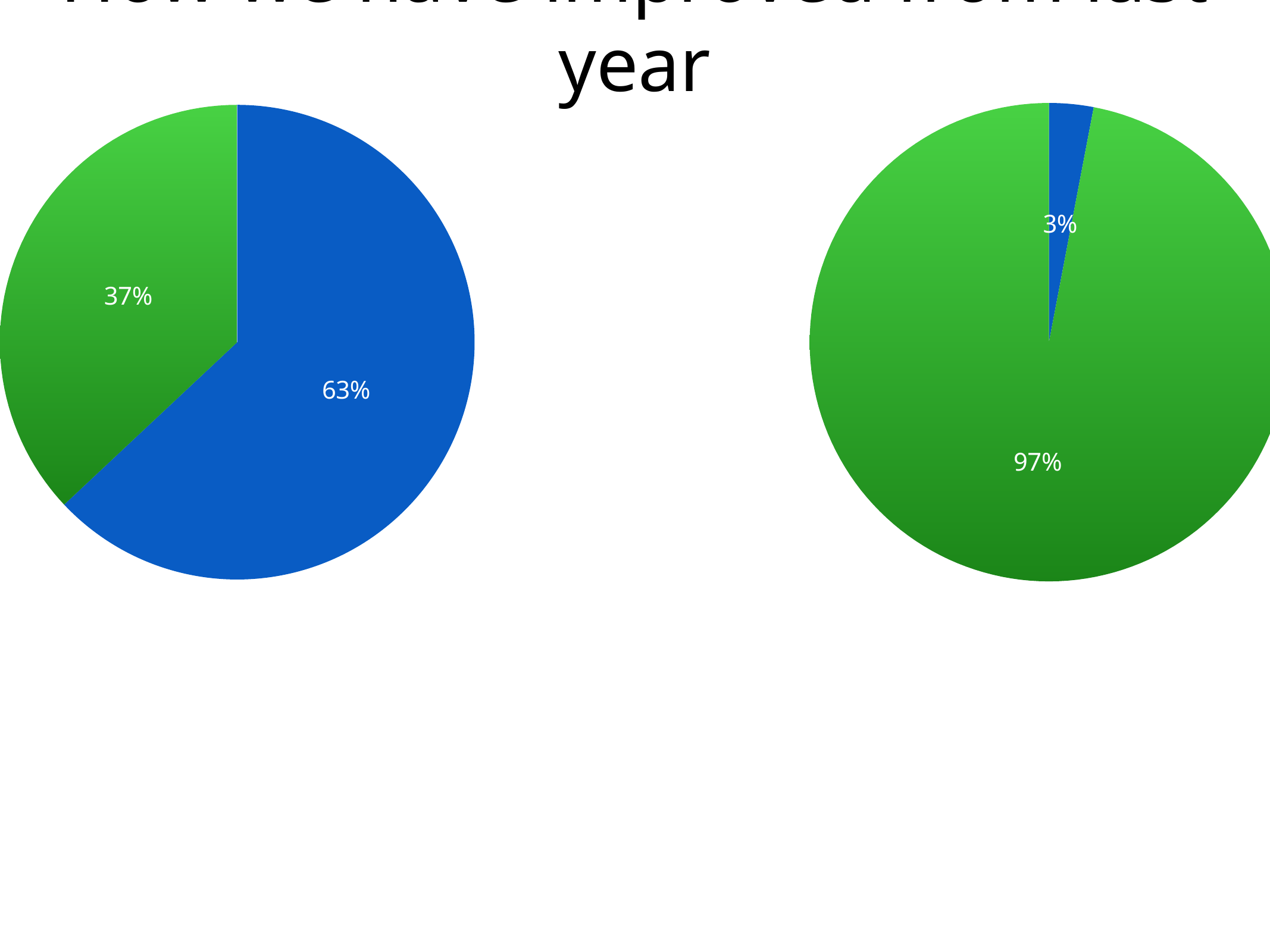
Is the blue slice larger in the left pie chart or the right pie chart? the left pie chart In the left pie chart, what share does the blue slice represent? 63% In the left pie chart, by how many percentage points does the blue slice exceed the green slice? 26 percentage points In the right pie chart, what share does the green slice represent? 97% In the right pie chart, which slice is the smallest? the blue slice (3%) In the right pie chart, what share does the blue slice represent? 3% In the right pie chart, what is the difference between the green and blue slices? 94 percentage points How many slices does the right pie chart have? 2 How many pie charts are shown on the slide? 2 What type of chart is shown on the left of the slide? pie chart In the left pie chart, which slice is the largest? the blue slice (63%)